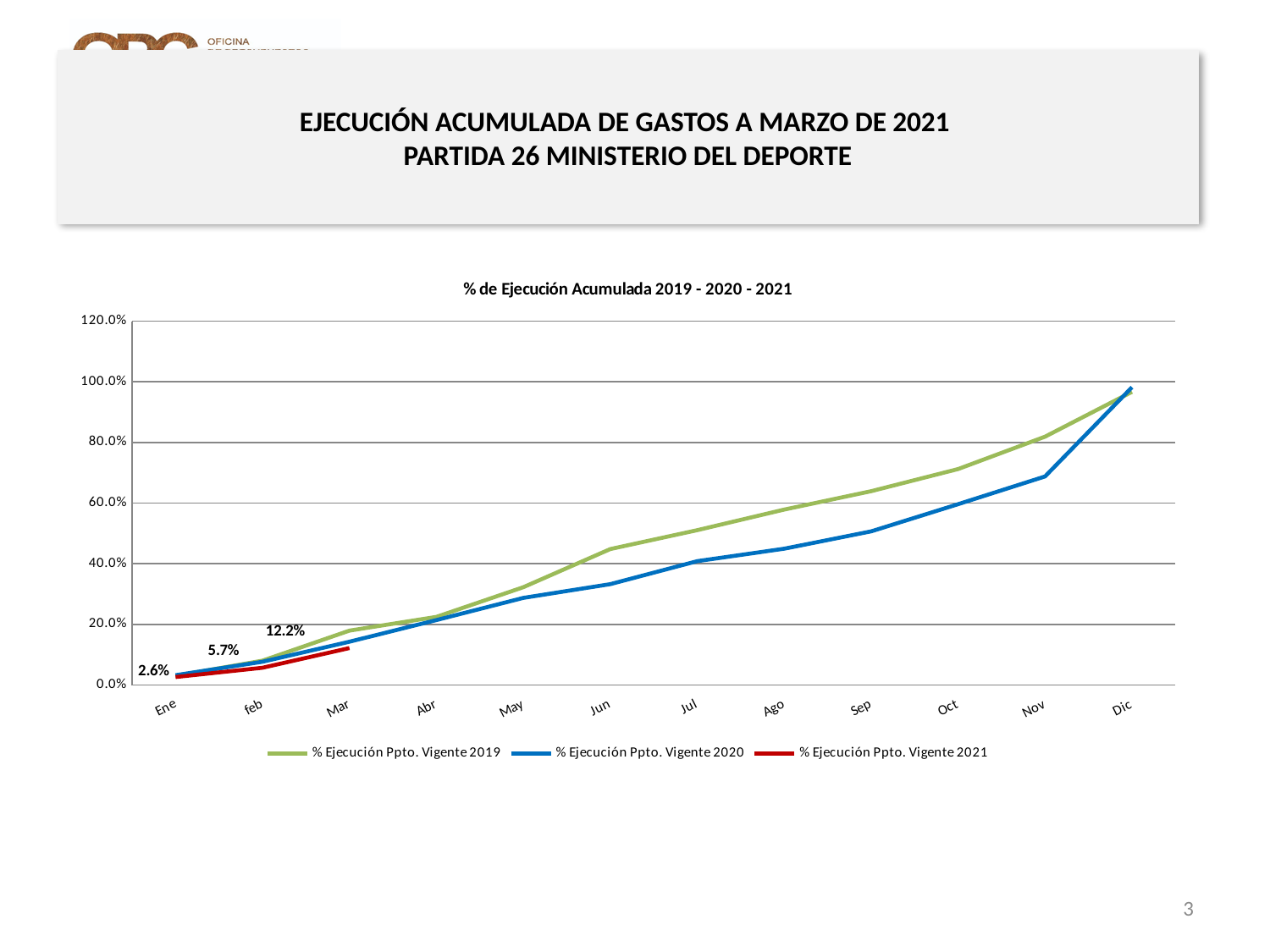
What is the value of % Ejecución Ppto. Vigente 2021 in feb? 5.7% How many series does the legend list? 3 What kind of chart is shown on the slide? line chart Does the % Ejecución Ppto. Vigente 2019 series rise or fall from Ene to Dic? rise What is the value of % Ejecución Ppto. Vigente 2021 in Ene? 2.6% What is the value of % Ejecución Ppto. Vigente 2021 in Mar? 12.2% In Jun, which series is larger: % Ejecución Ppto. Vigente 2019 or % Ejecución Ppto. Vigente 2020? % Ejecución Ppto. Vigente 2019 In which month does the % Ejecución Ppto. Vigente 2021 series reach its highest value? Mar What is the title of the chart? % de Ejecución Acumulada 2019 - 2020 - 2021 Is the value for % Ejecución Ppto. Vigente 2020 in Nov greater or less than 80.0%? less What is the difference between the Mar and Ene values of % Ejecución Ppto. Vigente 2021? 9.6% How many months are shown on the x axis? 12